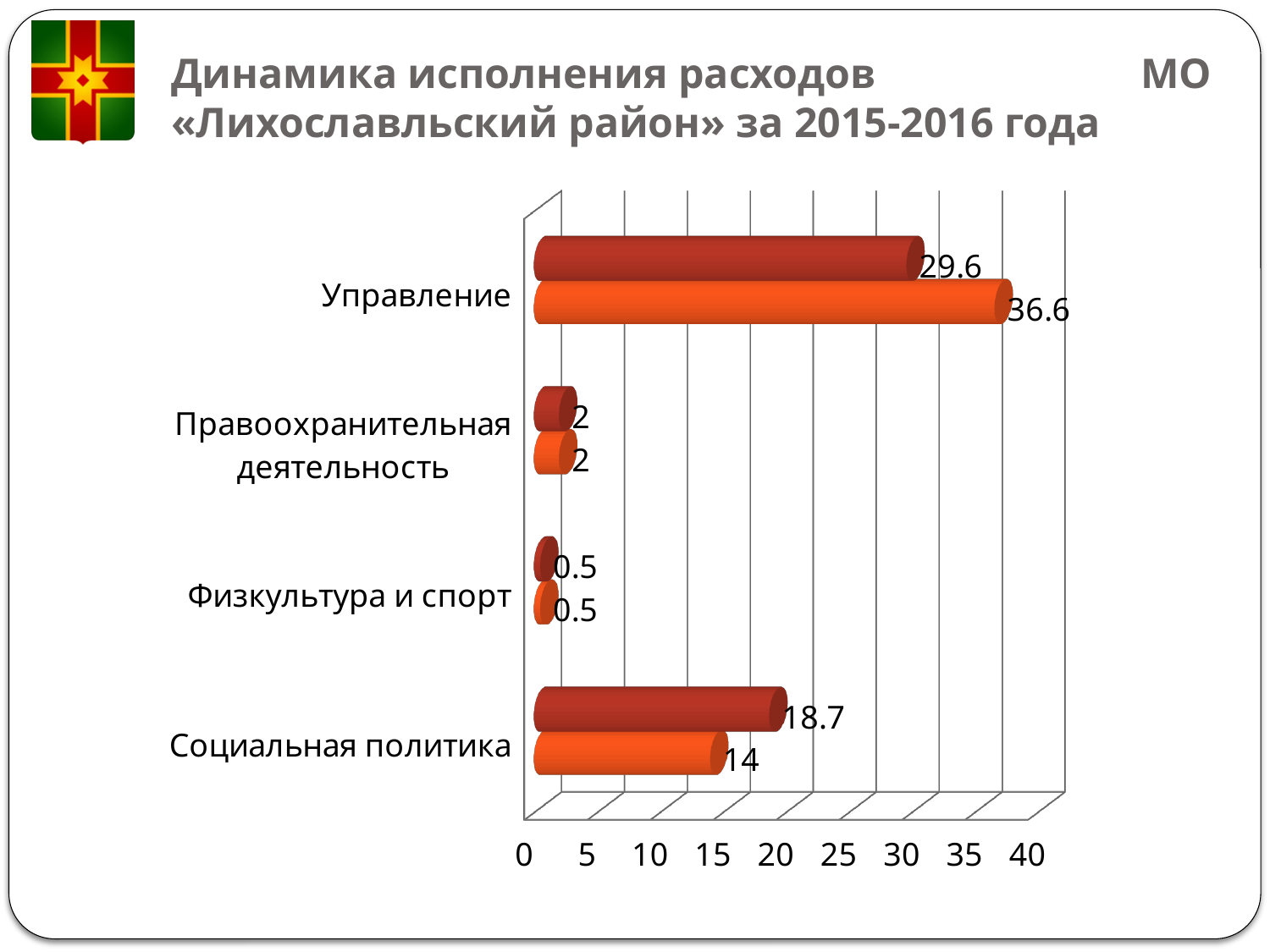
What is the value of the dark red bar for Управление? 29.6 What is the value of the orange bar for Управление? 36.6 How many categories are shown on the chart? 4 What kind of chart is shown on the slide? bar chart What is the value of the orange bar for Физкультура и спорт? 0.5 What is the value of the dark red bar for Социальная политика? 18.7 Which category has the highest value among the orange bars? Управление What is the value of the orange bar for Социальная политика? 14 What is the difference between the dark red and orange bars for Социальная политика? 4.7 Which category has the lowest value among the dark red bars? Физкультура и спорт What is the difference between the orange and dark red bars for Управление? 7 For Социальная политика, which bar is larger, the dark red or the orange one? dark red